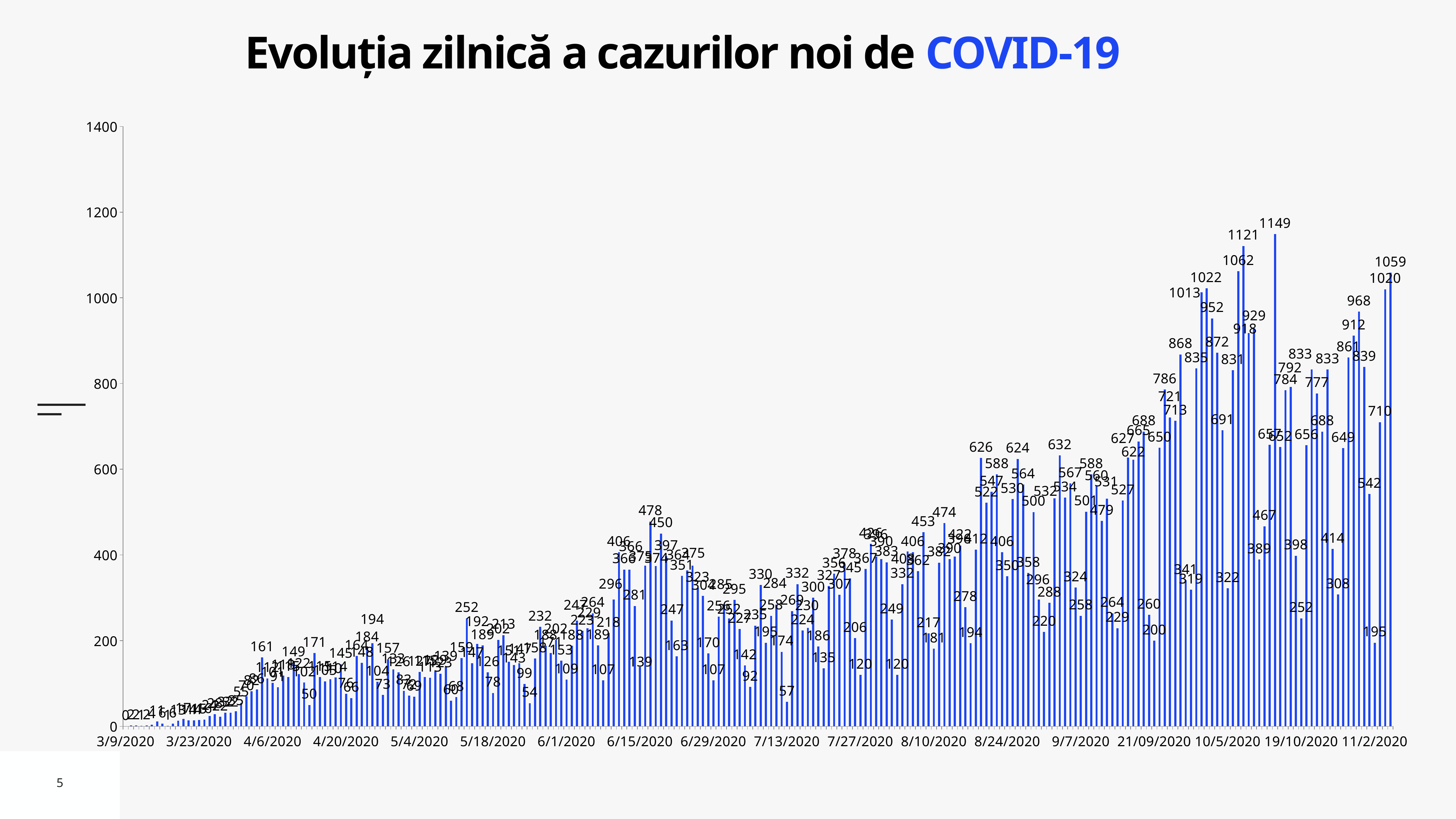
What is the difference between the bars labelled 1059 and 1020? 39 What is the maximum value shown on the y axis? 1400 Which is larger, the bar labelled 1149 or the bar labelled 1121? 1149 What is the title of the chart? Evoluția zilnică a cazurilor noi de COVID-19 What is the highest daily value labelled on the chart? 1149 Is the rightmost bar on the chart greater or less than 1000? greater What is the difference between the bars labelled 1149 and 1121? 28 What kind of chart is shown on the slide? bar chart Overall, do the daily values rise or fall from left to right along the x axis? rise What is the second highest daily value labelled on the chart? 1121 Is the highest bar on the chart greater or less than 1200? less What is the first date label shown on the x axis? 3/9/2020